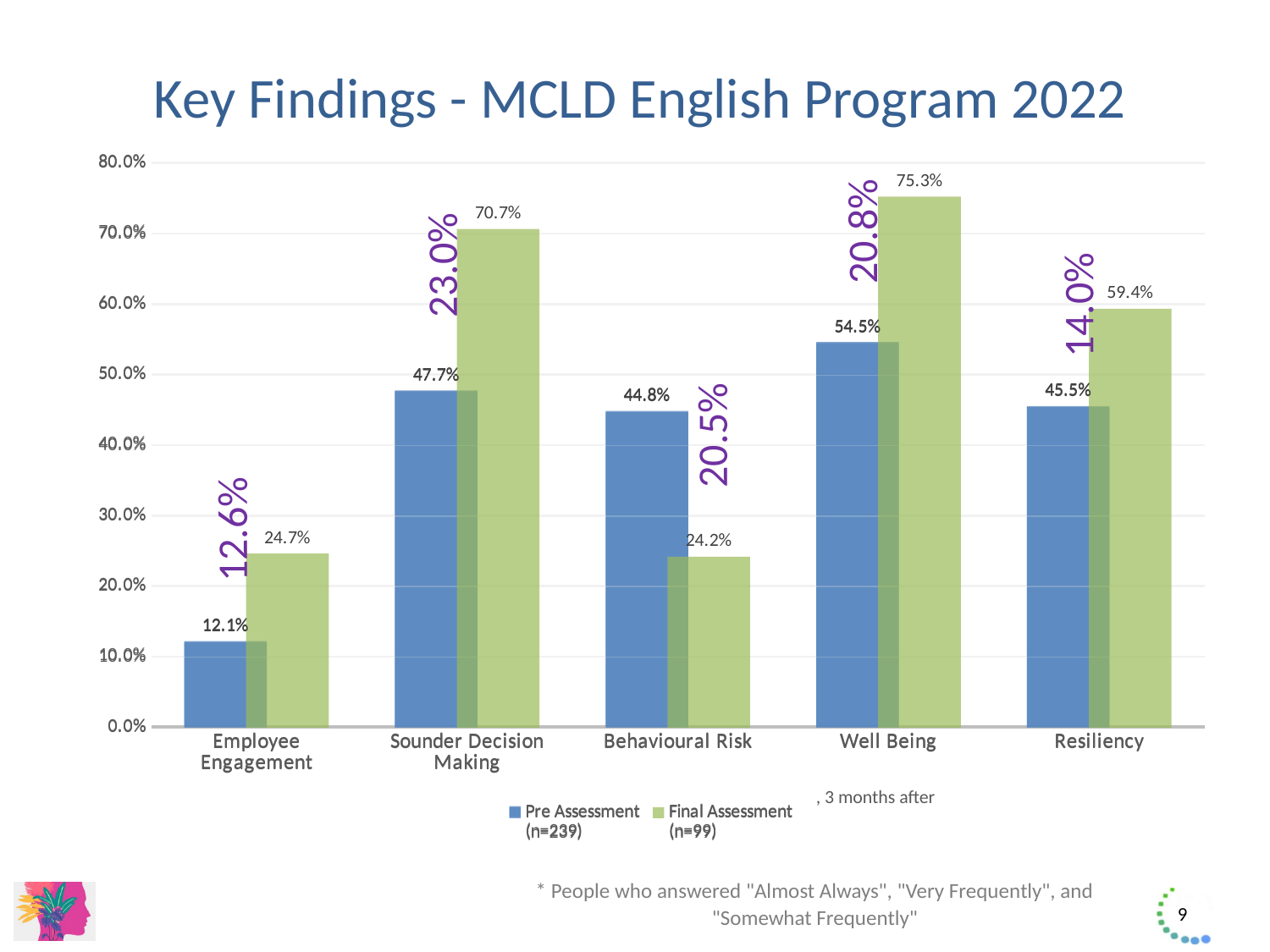
What is the Pre Assessment value for Employee Engagement? 12.1% What is the difference between the Final Assessment and Pre Assessment values for Resiliency? 13.9% What kind of chart is shown on the slide? Bar chart Which category has the lowest Pre Assessment value? Employee Engagement How many series does the legend list? 2 For Behavioural Risk, which is larger: the Pre Assessment value or the Final Assessment value? Pre Assessment Which category has the highest Final Assessment value? Well Being What is the Final Assessment value for Sounder Decision Making? 70.7% What is the Final Assessment value for Well Being? 75.3% What is the title of the slide? Key Findings - MCLD English Program 2022 How many categories are shown on the x axis? 5 What is the Pre Assessment value for Resiliency? 45.5%